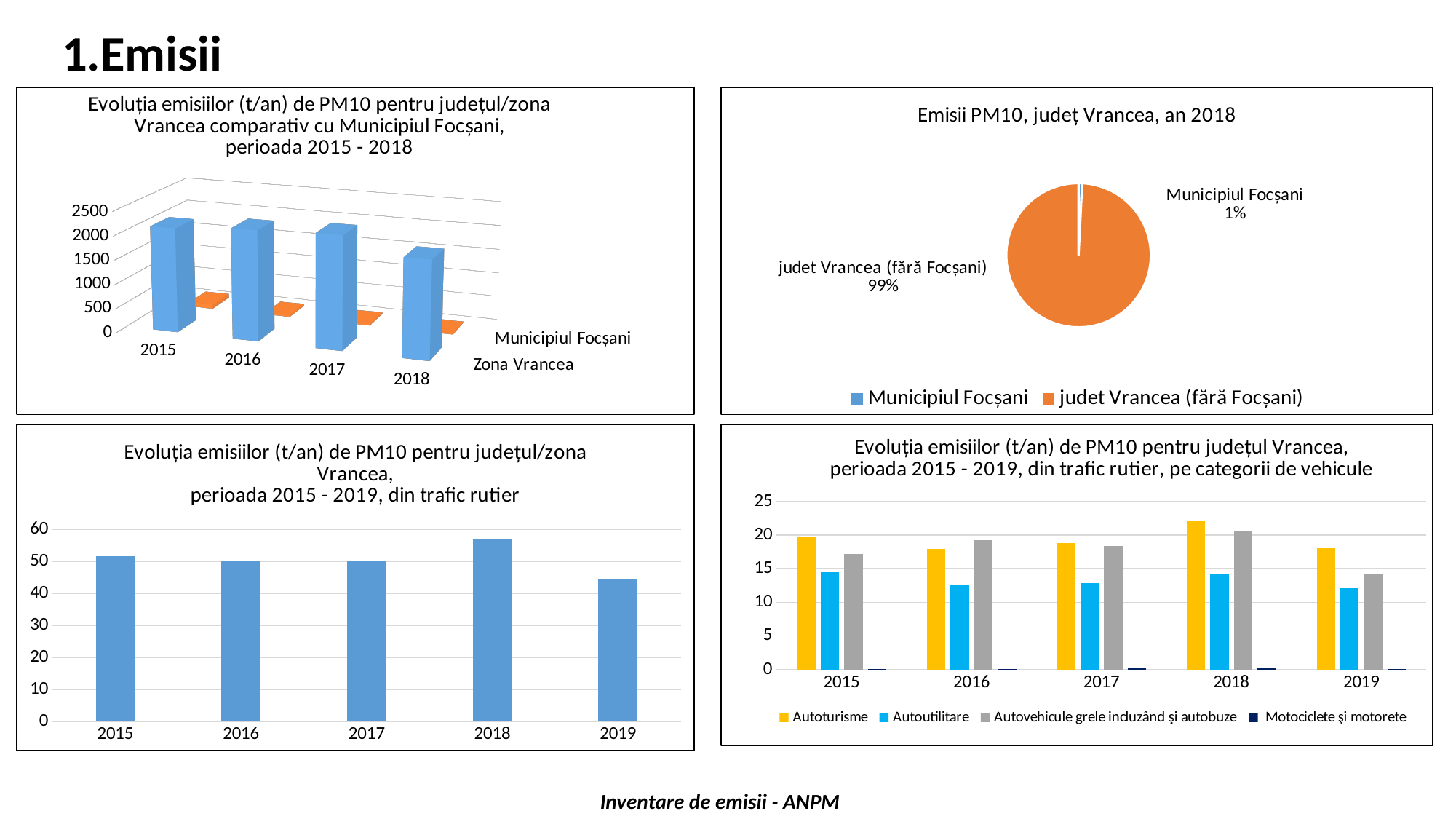
In the bottom-right chart on PM10 emissions by vehicle category, which series has the lowest value in 2018? Motociclete și motorete In the top-left chart comparing Zona Vrancea with Municipiul Focșani for 2015 - 2018, which series is larger in 2015? Zona Vrancea In the bottom-right chart on PM10 emissions by vehicle category, which is larger in 2018: Autoturisme or Autoutilitare? Autoturisme In the bottom-left chart on road traffic PM10 emissions, is the value for 2019 greater or less than 50? less In the pie chart 'Emisii PM10, județ Vrancea, an 2018', what share does județ Vrancea (fără Focșani) have? 99% In the bottom-left chart on road traffic PM10 emissions for 2015 - 2019, which year has the lowest value? 2019 In the bottom-right chart on PM10 emissions by vehicle category, is the value for Autoturisme in 2018 greater or less than 20? greater How many years are shown on the x axis of the bottom-left chart on road traffic PM10 emissions? 5 In the pie chart 'Emisii PM10, județ Vrancea, an 2018', what share does Municipiul Focșani have? 1% In the bottom-left chart on road traffic PM10 emissions for 2015 - 2019, which year has the highest value? 2018 How many series does the legend list in the bottom-right chart on PM10 emissions by vehicle category? 4 What kind of chart is the top-right chart 'Emisii PM10, județ Vrancea, an 2018'? pie chart